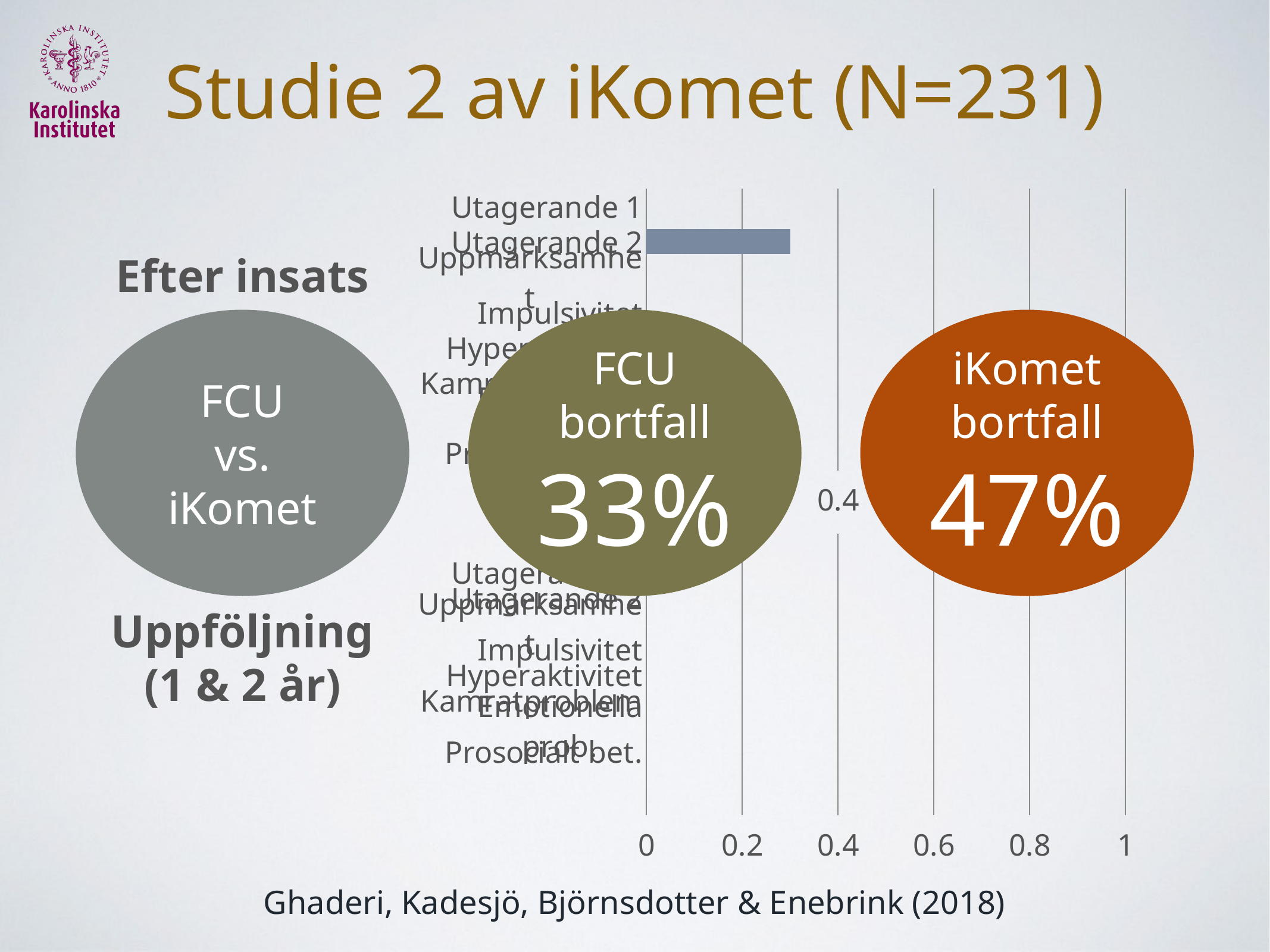
What kind of chart is shown on the slide? bar chart What is the highest value shown on the x axis of the chart? 1 Is the value for Utagerande 2 greater or less than 0.2? greater What is the lowest value shown on the x axis of the chart? 0 Is the value for Utagerande 2 greater or less than 0.4? less